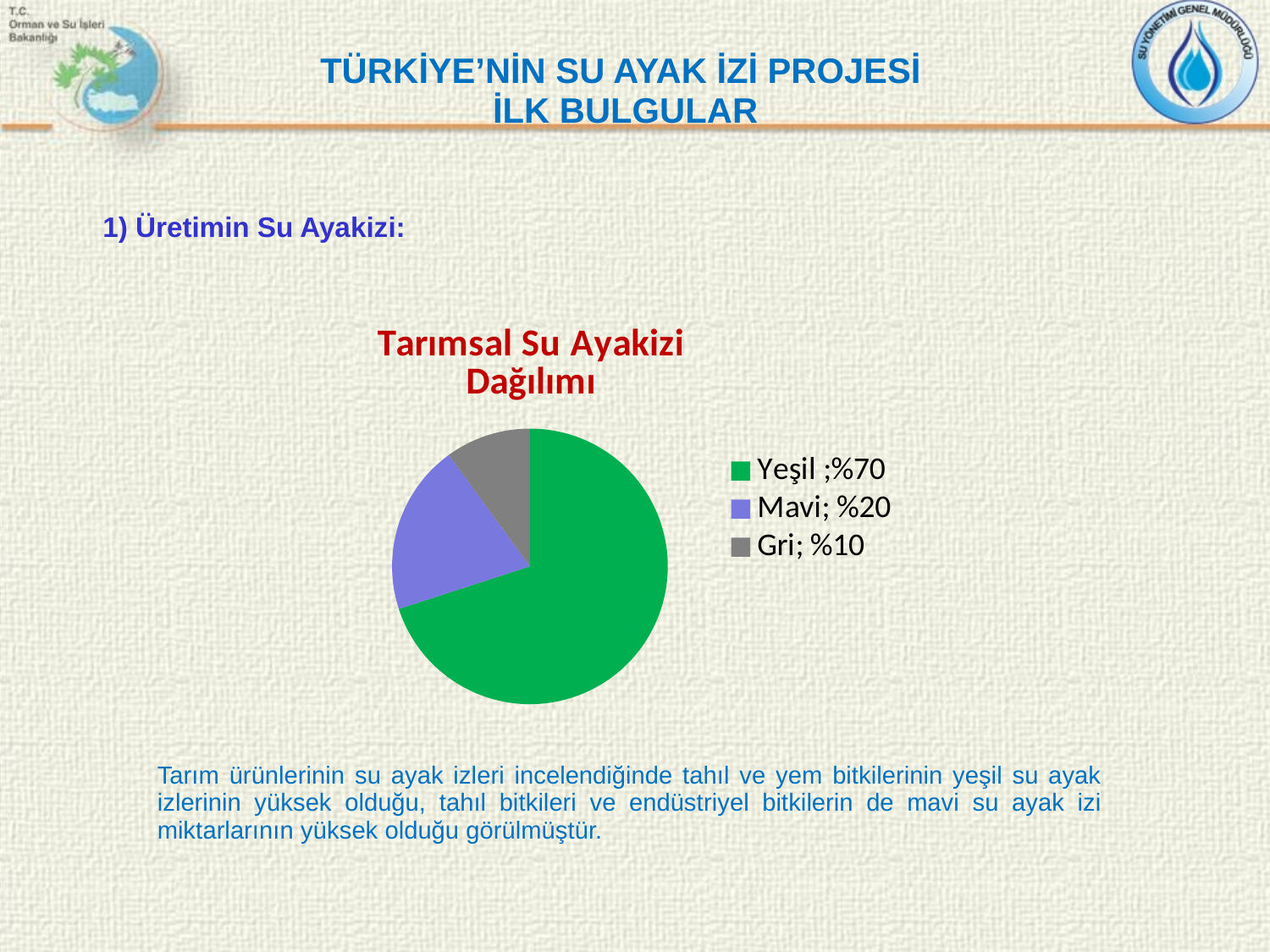
What is the title of the pie chart? Tarımsal Su Ayakizi Dağılımı What is the difference between the Mavi and Gri shares? %10 Which is larger, the Mavi share or the Gri share? Mavi What share of the pie does Gri have? %10 What colour is the Gri slice in the pie chart? grey What kind of chart is shown on the slide? pie chart What share of the pie does Mavi have? %20 What is the difference between the Yeşil and Mavi shares? %50 Which slice of the pie chart is the smallest? Gri Which slice of the pie chart is the largest? Yeşil What share of the pie does Yeşil have? %70 How many slices does the pie chart have? 3